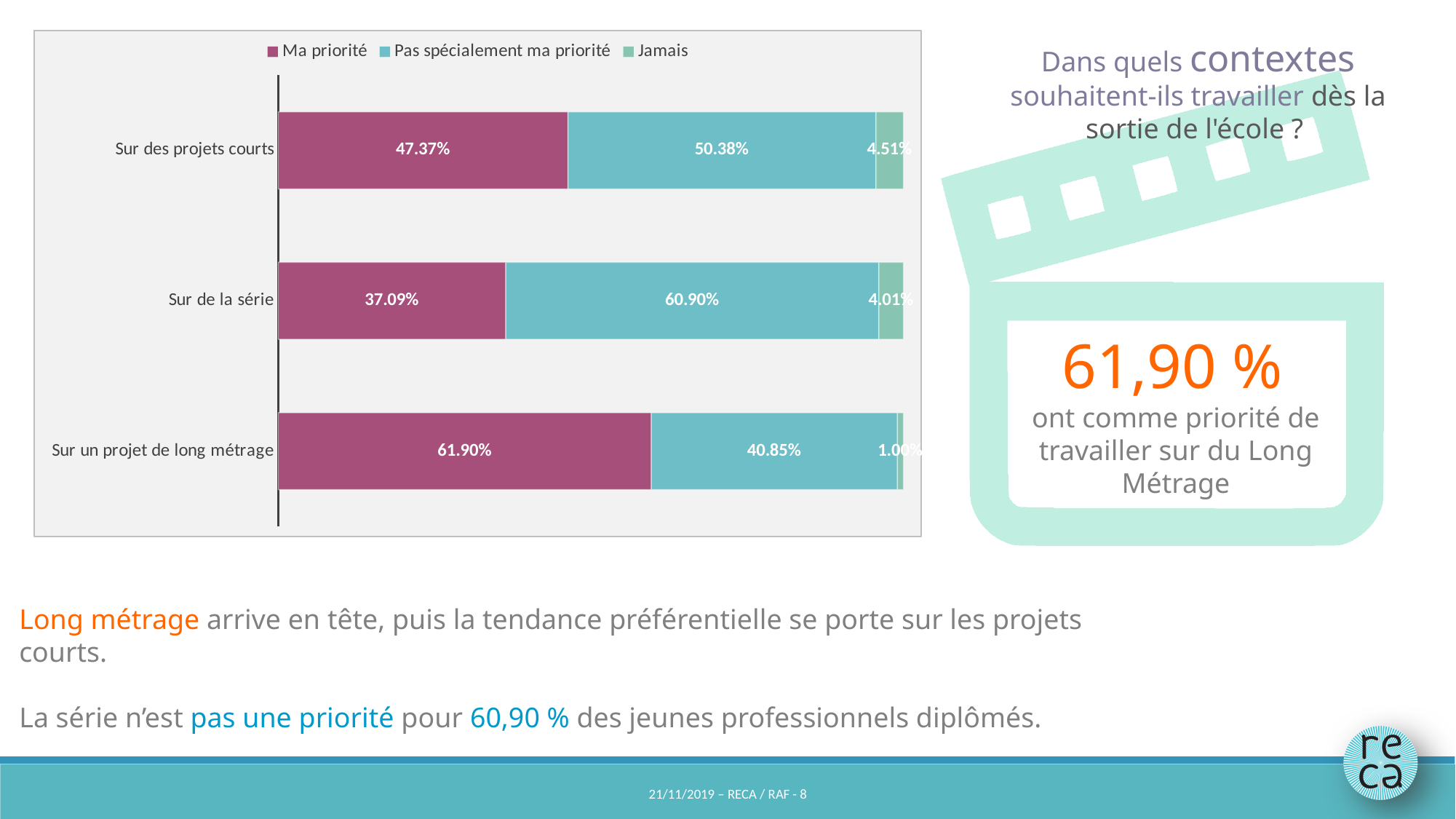
What is the 'Pas spécialement ma priorité' value for 'Sur de la série'? 60.90% What kind of chart is shown on the slide? Stacked bar chart What is the 'Ma priorité' value for 'Sur un projet de long métrage'? 61.90% How many series does the legend list? 3 Which legend entry is shown in the dark pink/magenta colour? Ma priorité Which category has the highest 'Ma priorité' value? Sur un projet de long métrage How many categories are plotted on the chart? 3 What is the difference between the 'Jamais' values for 'Sur des projets courts' and 'Sur de la série'? 0.50 percentage points What is the difference between the 'Ma priorité' values for 'Sur un projet de long métrage' and 'Sur des projets courts'? 14.53 percentage points What is the 'Jamais' value for 'Sur des projets courts'? 4.51% Which category has the lowest 'Jamais' value? Sur un projet de long métrage Which is larger: the 'Pas spécialement ma priorité' value for 'Sur de la série' or for 'Sur des projets courts'? Sur de la série